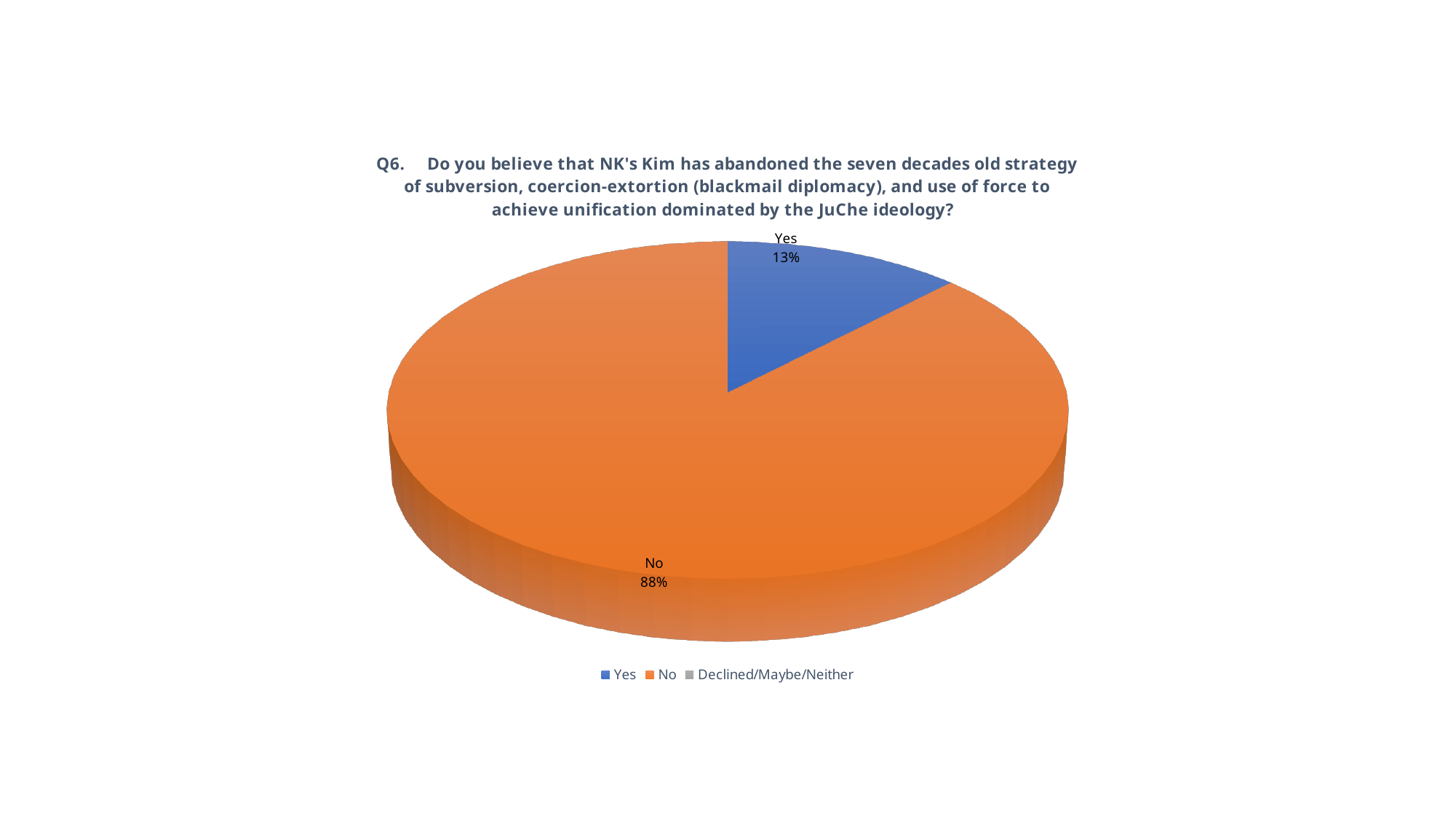
How many slices are visibly labelled with a percentage on the pie? 2 Which response has the largest share of the pie? No What percentage of respondents answered "Yes"? 13% Is the share for "No" larger or smaller than the share for "Yes"? Larger How many entries does the legend list? 3 Which of the two labelled slices is smaller, Yes or No? Yes What is the difference in percentage points between the "No" and "Yes" shares? 75 percentage points What kind of chart is shown on the slide? Pie chart What is the third legend entry, after Yes and No? Declined/Maybe/Neither What percentage of respondents answered "No"? 88% What colour is the "No" slice? Orange